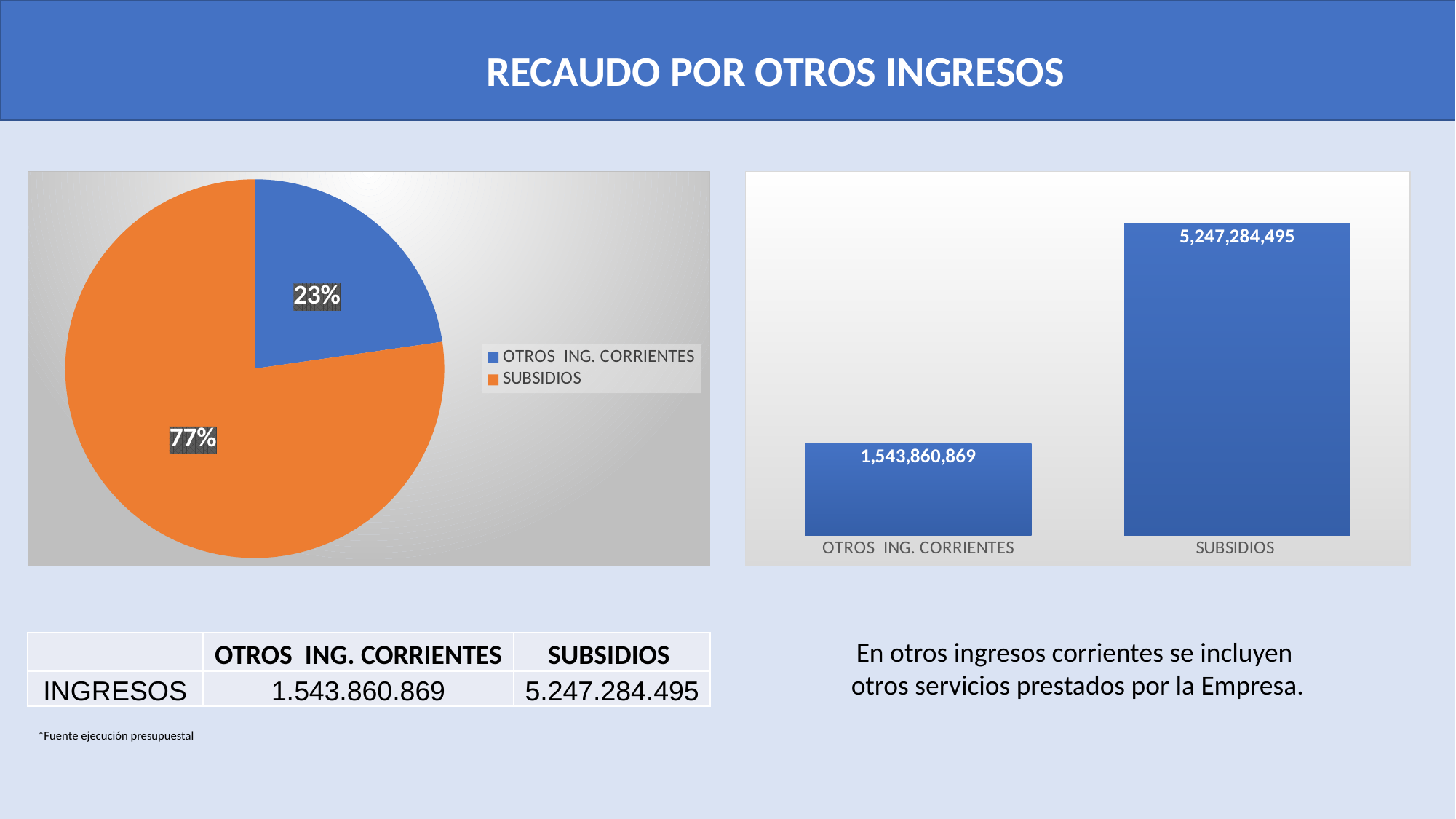
In the bar chart on the right, which category has the lowest value? OTROS ING. CORRIENTES What kind of chart is the chart on the left? pie chart In the bar chart on the right, which category has the highest value? SUBSIDIOS In the pie chart on the left, what colour is the SUBSIDIOS slice? orange In the bar chart on the right, what is the value for SUBSIDIOS? 5,247,284,495 In the pie chart on the left, what share does SUBSIDIOS have? 77% What kind of chart is the chart on the right? bar chart In the bar chart on the right, what is the difference between the values for SUBSIDIOS and OTROS ING. CORRIENTES? 3,703,423,626 In the pie chart on the left, what share does OTROS ING. CORRIENTES have? 23% In the pie chart on the left, which slice is larger, SUBSIDIOS or OTROS ING. CORRIENTES? SUBSIDIOS In the bar chart on the right, what is the value for OTROS ING. CORRIENTES? 1,543,860,869 How many categories are shown in the bar chart on the right? 2